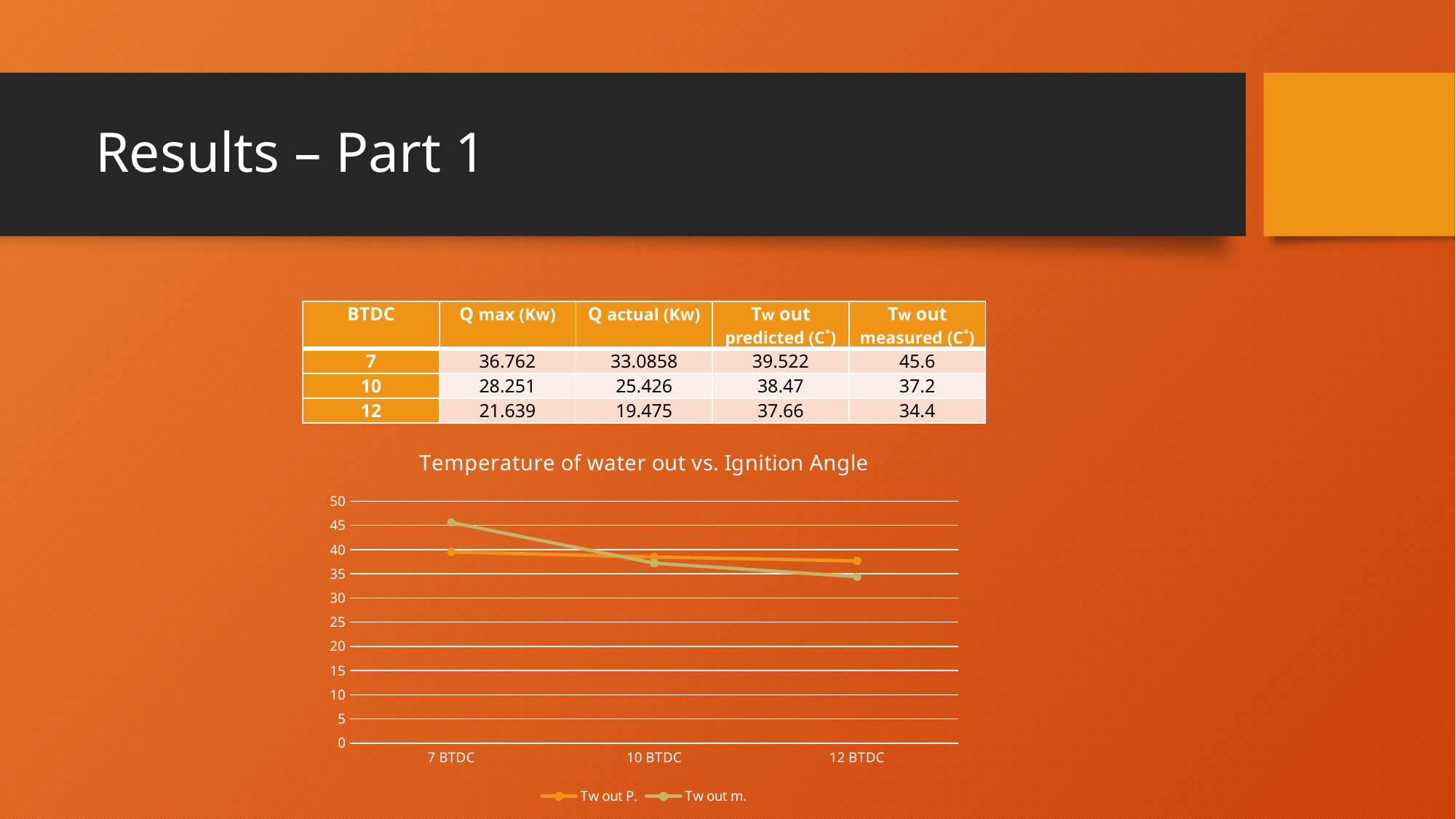
What is the title of the chart? Temperature of water out vs. Ignition Angle Is the value for Tw out m. at 7 BTDC greater or less than 40? greater What are the names of the two series in the chart's legend? Tw out P. and Tw out m. Does the Tw out m. series rise or fall from 7 BTDC to 12 BTDC? fall At which ignition angle is the Tw out m. series lowest? 12 BTDC At 12 BTDC, which series has the higher value, Tw out P. or Tw out m.? Tw out P. At 7 BTDC, which series has the higher value, Tw out P. or Tw out m.? Tw out m. How many ignition angle categories are plotted on the x axis of the chart? 3 At which ignition angle is the Tw out m. series highest? 7 BTDC Does the Tw out P. series rise or fall from 7 BTDC to 12 BTDC? fall How many series does the chart's legend list? 2 What kind of chart is shown on the slide? line chart